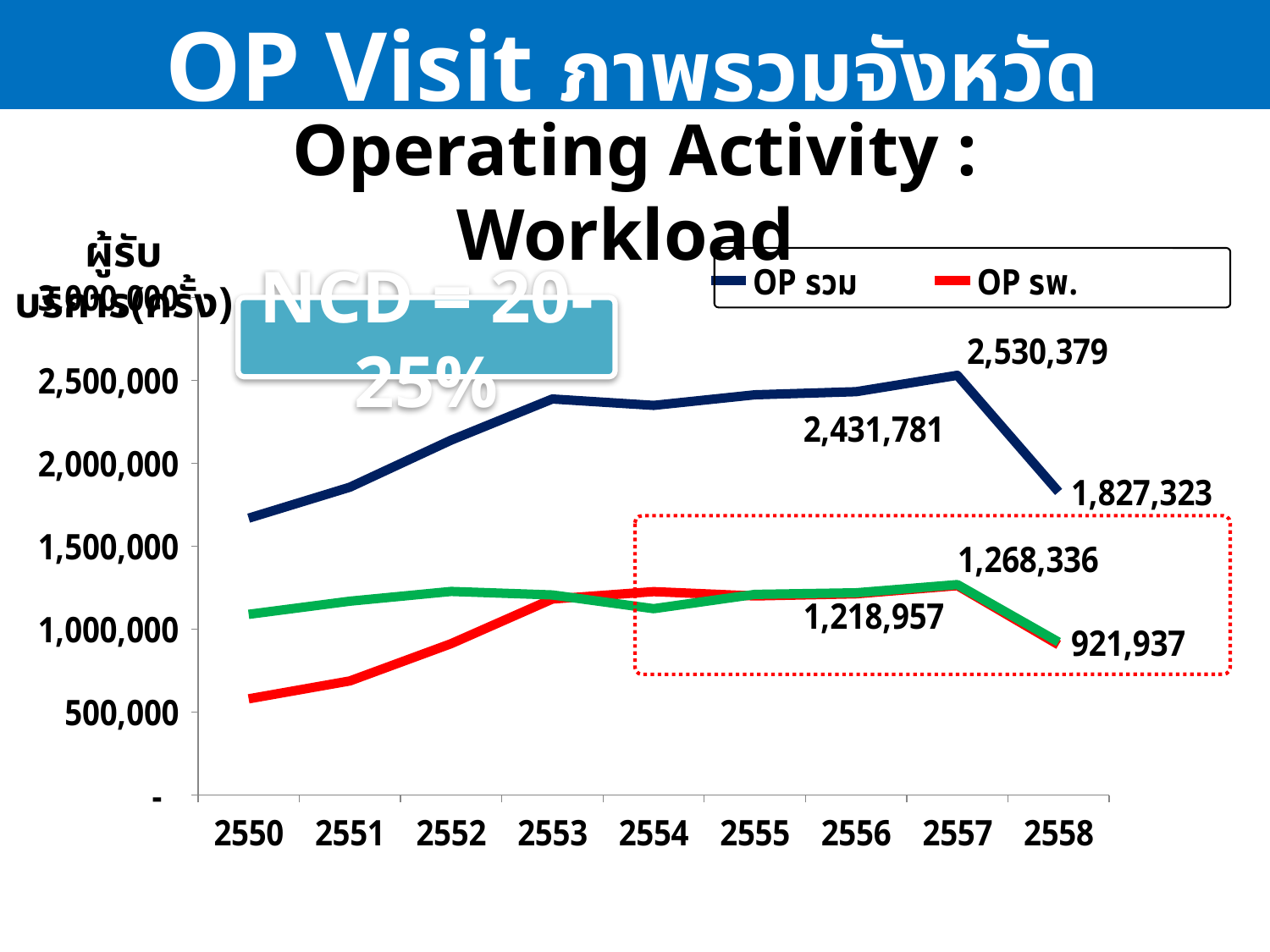
By how much did OP รวม fall from 2557 to 2558? 703,056 In which year is OP รวม at its highest? 2557 What is the value of OP รวม in 2557? 2,530,379 How many series does the legend list? 2 Is the value for OP รวม in 2550 greater or less than 2,000,000? less In which year is OP รพ. at its lowest? 2550 What is the value of OP รวม in 2558? 1,827,323 How many years are shown along the x axis? 9 What kind of chart is shown on the slide? line chart